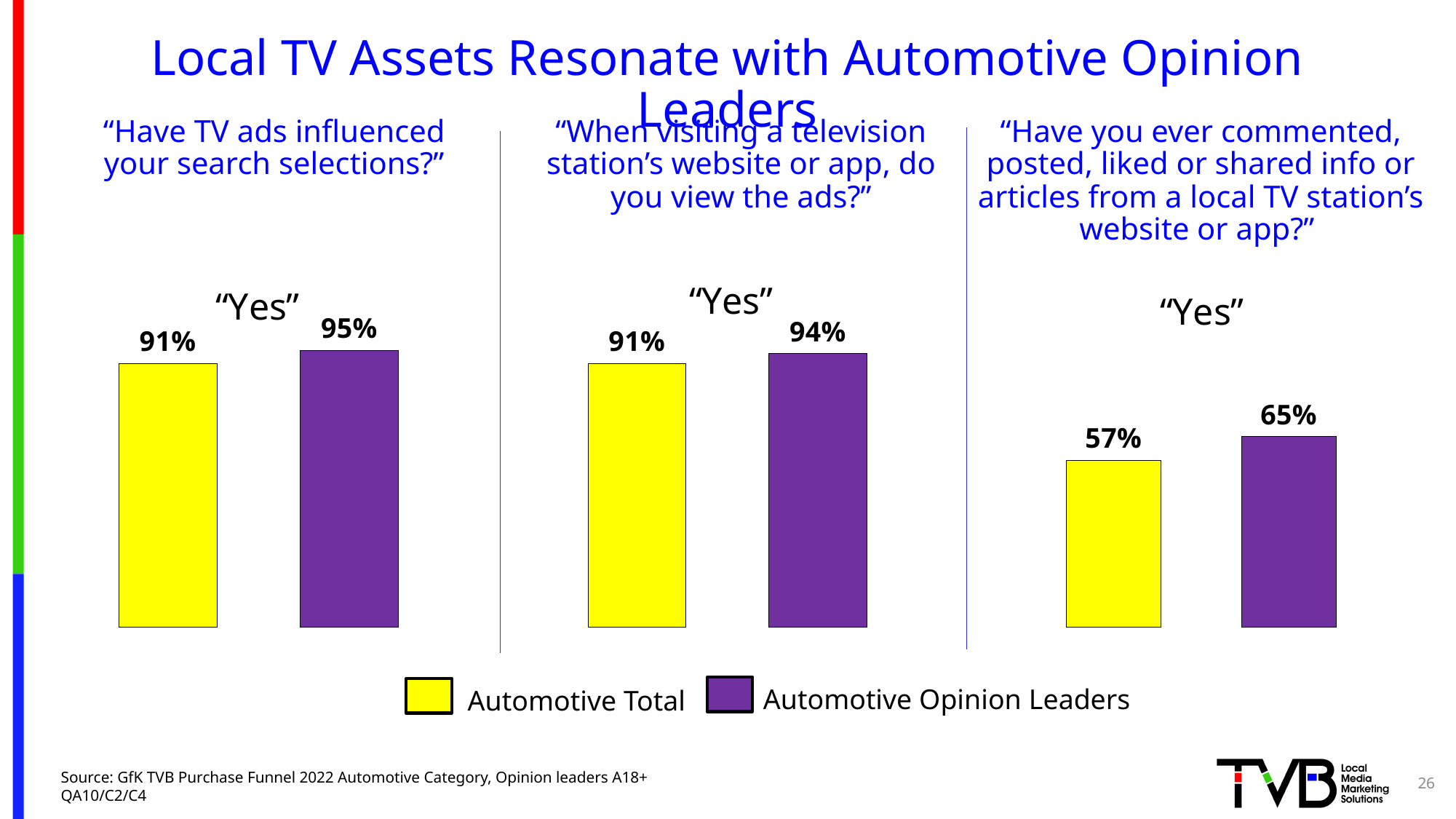
In the right chart ('Have you ever commented, posted, liked or shared...'), what is the value for Automotive Opinion Leaders? 65% In the right chart ('Have you ever commented, posted, liked or shared info or articles from a local TV station's website or app?'), what is the value for Automotive Total? 57% In the middle chart ('When visiting a television station's website or app, do you view the ads?'), what is the value for Automotive Opinion Leaders? 94% How many series does the legend list? 2 In the right chart ('Have you ever commented, posted, liked or shared...'), which group has the lower value? Automotive Total What type of chart is used on this slide? Bar chart In the middle chart ('When visiting a television station's website or app, do you view the ads?'), which group has the higher 'Yes' percentage? Automotive Opinion Leaders In the left chart ('Have TV ads influenced your search selections?'), what percentage of Automotive Opinion Leaders answered 'Yes'? 95% In the left chart ('Have TV ads influenced your search selections?'), what is the difference between Automotive Opinion Leaders and Automotive Total? 4 percentage points In the right chart ('Have you ever commented, posted, liked or shared...'), what is the difference between Automotive Opinion Leaders and Automotive Total? 8 percentage points In the left chart ('Have TV ads influenced your search selections?'), what percentage of Automotive Total answered 'Yes'? 91% Which colour represents Automotive Opinion Leaders in the legend? Purple